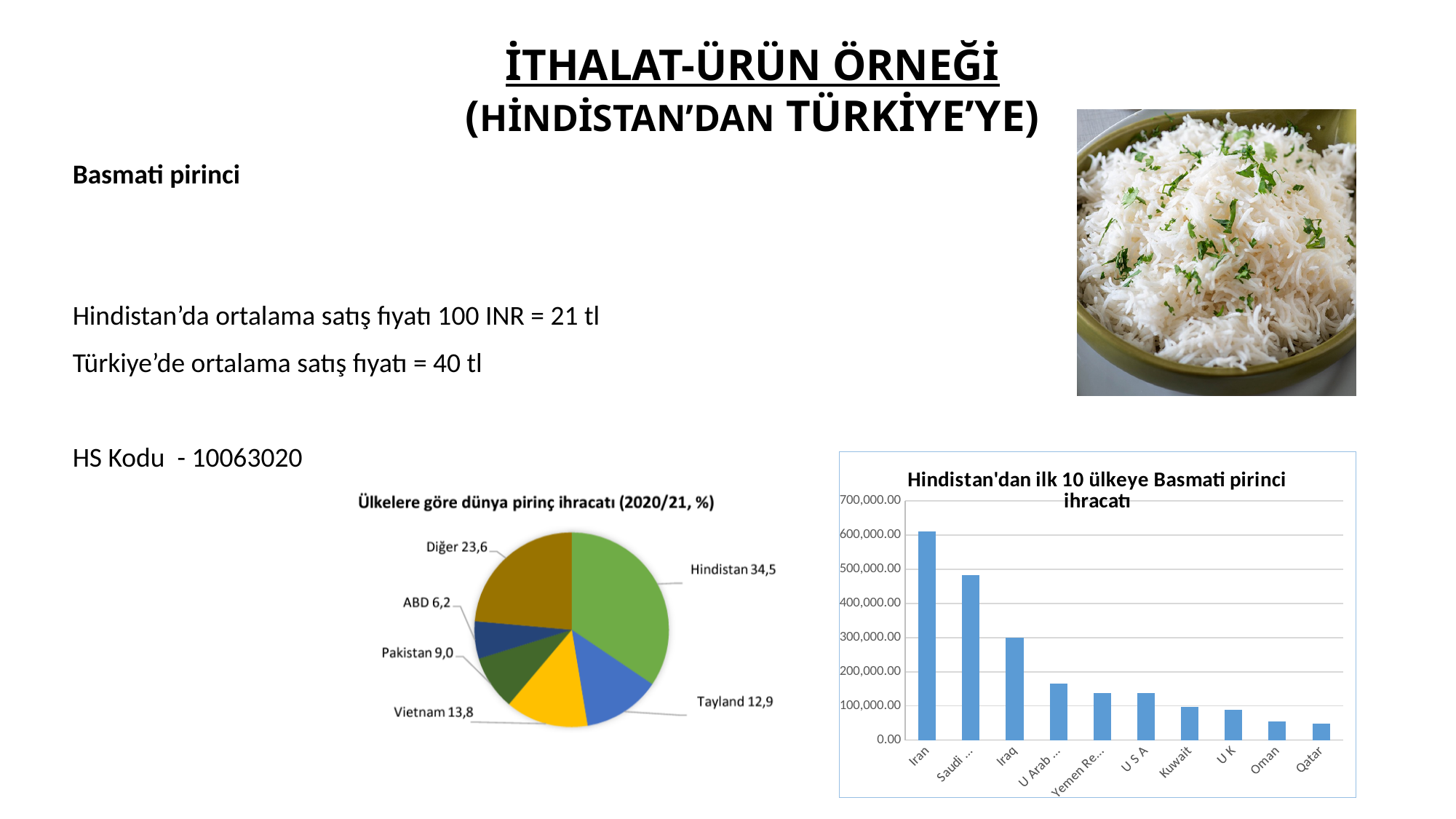
In the pie chart 'Ülkelere göre dünya pirinç ihracatı (2020/21, %)', what is the value for Vietnam? 13,8 In the pie chart 'Ülkelere göre dünya pirinç ihracatı (2020/21, %)', which named country has the smallest share? ABD What kind of chart is 'Hindistan'dan ilk 10 ülkeye Basmati pirinci ihracatı'? bar chart In the pie chart 'Ülkelere göre dünya pirinç ihracatı (2020/21, %)', which is larger, Pakistan or ABD? Pakistan In the pie chart 'Ülkelere göre dünya pirinç ihracatı (2020/21, %)', which slice is the largest? Hindistan In the bar chart 'Hindistan'dan ilk 10 ülkeye Basmati pirinci ihracatı', do the values rise or fall from left to right? fall In the bar chart 'Hindistan'dan ilk 10 ülkeye Basmati pirinci ihracatı', is the value for Iraq greater or less than 200,000.00? greater In the pie chart 'Ülkelere göre dünya pirinç ihracatı (2020/21, %)', what is the difference between the values for Vietnam and Tayland? 0,9 How many slices does the pie chart 'Ülkelere göre dünya pirinç ihracatı (2020/21, %)' have? 6 In the bar chart 'Hindistan'dan ilk 10 ülkeye Basmati pirinci ihracatı', which country has the highest value? Iran In the pie chart 'Ülkelere göre dünya pirinç ihracatı (2020/21, %)', what is the value for Hindistan? 34,5